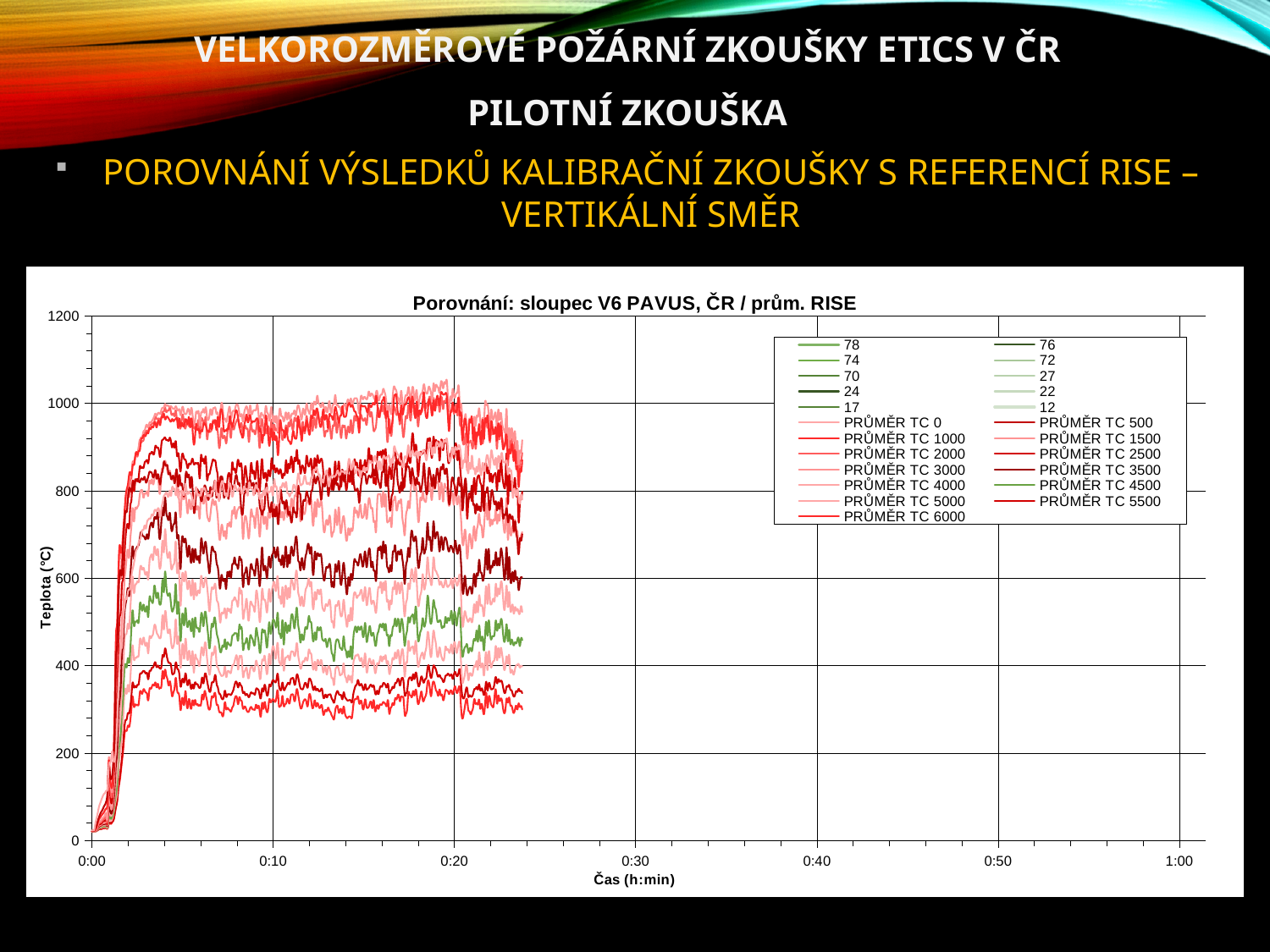
Are the temperature curves at 0:00 greater or less than 200 °C? less Are the highest temperature curves at 0:20 greater or less than 800 °C? greater Do the temperature curves rise or fall during the first few minutes after 0:00? rise How many series does the chart's legend list? 23 What is the label of the y axis of the chart? Teplota (°C) Do the plotted curves end before or after the 0:30 mark on the x axis? before Are the lowest temperature curves at 0:10 greater or less than 400 °C? less What is the highest value shown on the y axis of the chart? 1200 What is the last tick shown on the x axis of the chart? 1:00 What is the title of the chart? Porovnání: sloupec V6 PAVUS, ČR / prům. RISE What kind of chart is shown on the slide? line chart